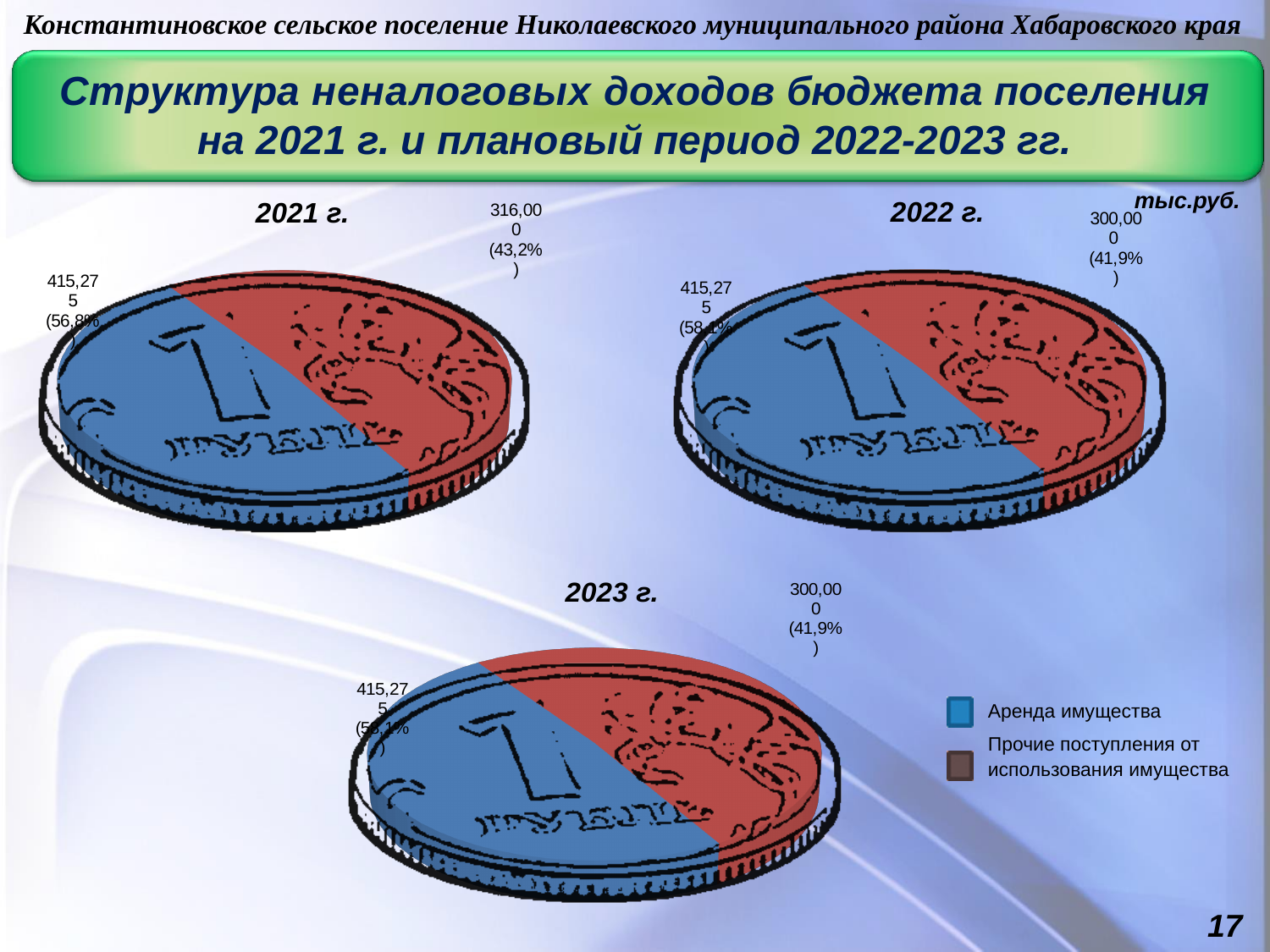
In the 2023 г. chart, what share of the pie does Прочие поступления от использования имущества take? 41,9% How many categories does the legend list for the charts on this slide? 2 What kind of chart is used for the 2021 г., 2022 г. and 2023 г. data on this slide? Pie chart In the 2022 г. chart, what is the difference between Аренда имущества and Прочие поступления от использования имущества? 115,275 In the 2021 г. chart, what is the difference between Аренда имущества and Прочие поступления от использования имущества? 99,275 In the 2021 г. chart, what is the value for Прочие поступления от использования имущества? 316,000 In the 2021 г. chart, what is the value for Аренда имущества? 415,275 In the 2022 г. chart, what is the value for Прочие поступления от использования имущества? 300,000 In the 2021 г. chart, what share of the pie does Аренда имущества take? 56,8% In the 2021 г. chart, what share of the pie does Прочие поступления от использования имущества take? 43,2% In the 2023 г. chart, what is the value for Аренда имущества? 415,275 In the 2022 г. chart, which category is larger: Аренда имущества or Прочие поступления от использования имущества? Аренда имущества